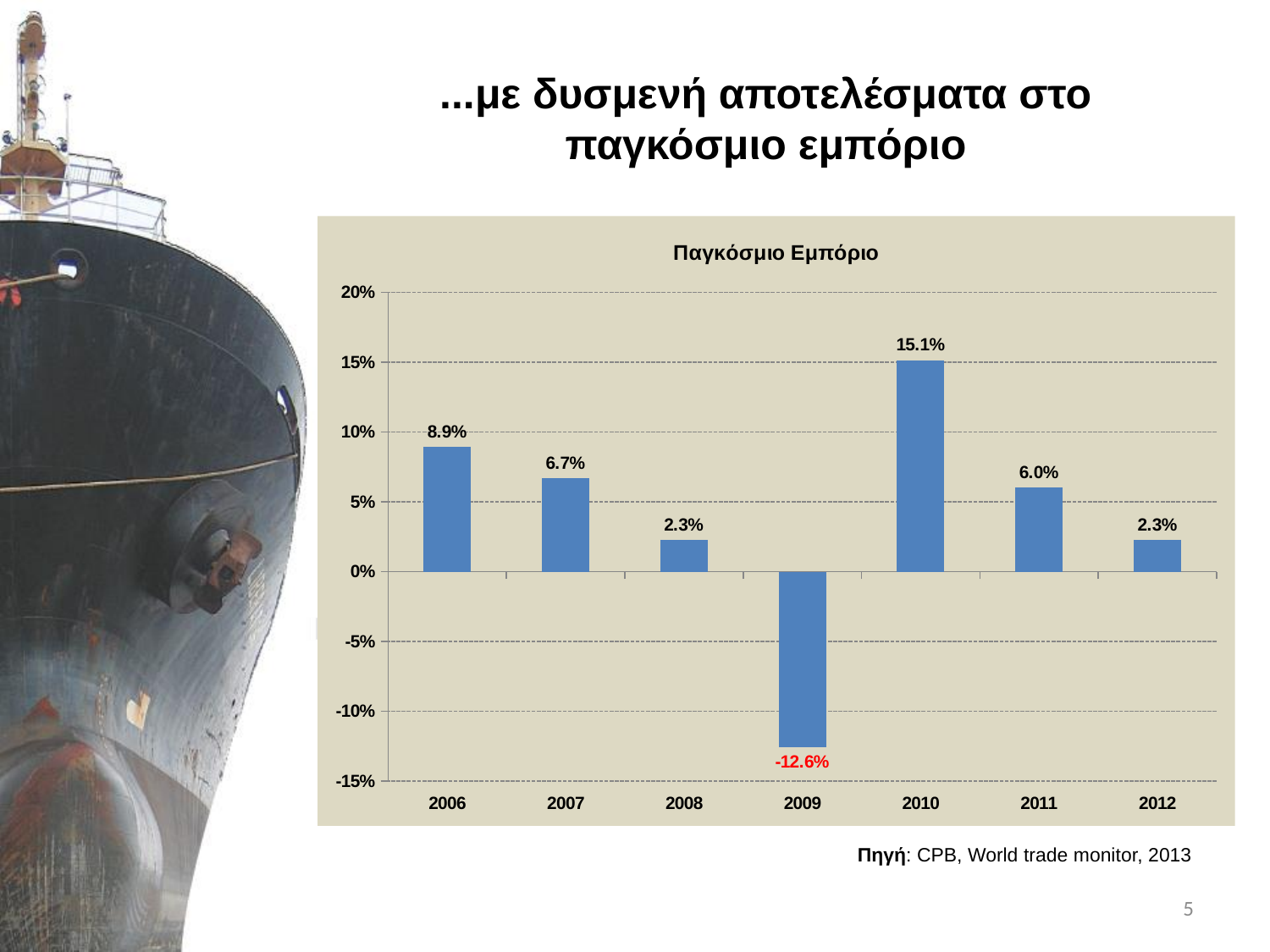
What is the value for 2006? 8.9% Which year has the lowest value? 2009 What is the title of the chart? Παγκόσμιο Εμπόριο How many years are shown on the x axis? 7 Which year has the highest value? 2010 Do the values rise or fall from 2006 to 2008? fall What is the value for 2011? 6.0% What is the value for 2009? -12.6% What is the difference between the values for 2010 and 2011? 9.1% Is the value for 2010 greater or less than 10%? greater Which is larger, the value for 2007 or the value for 2012? 2007 What kind of chart is this? bar chart